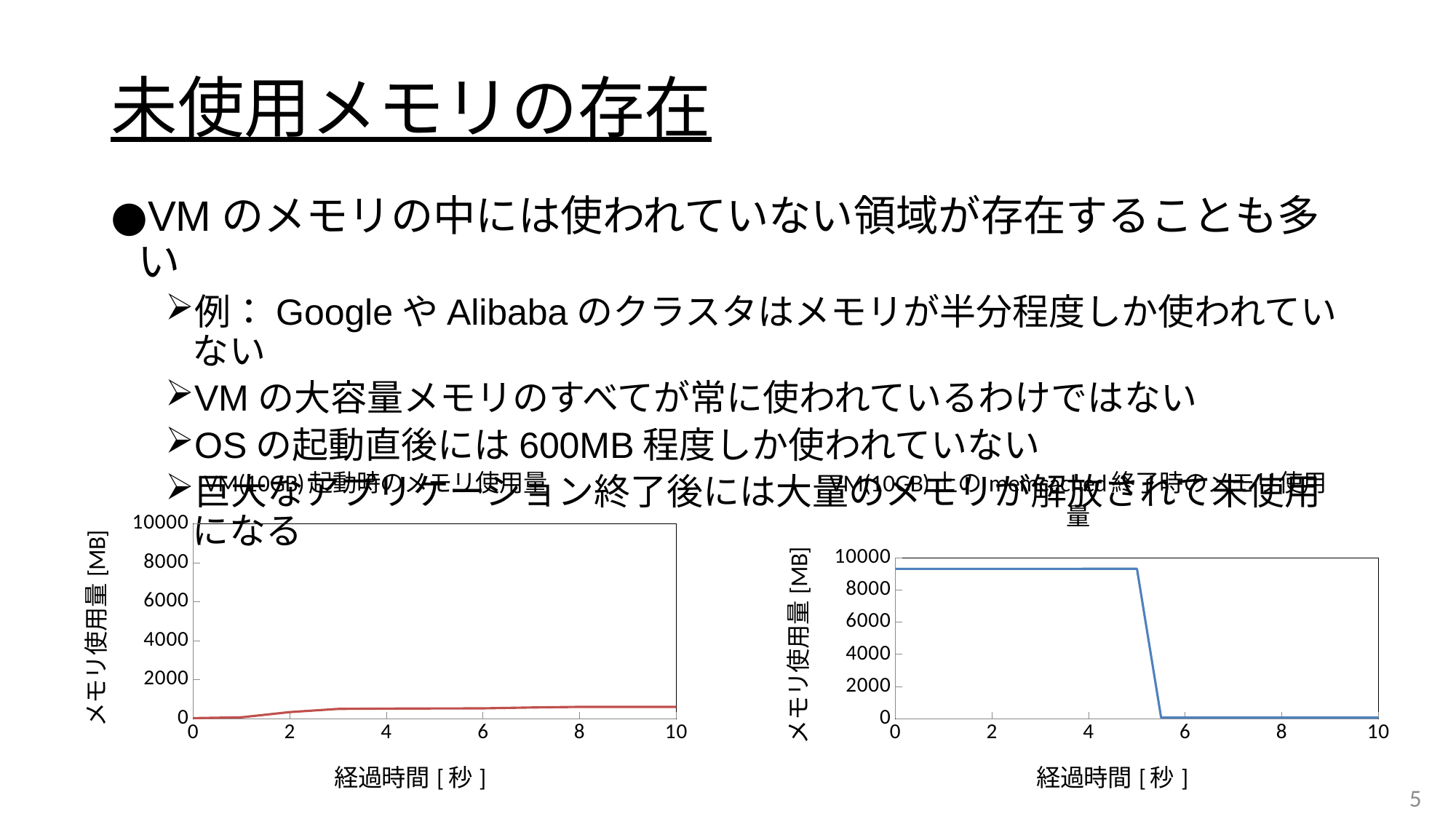
In the right chart, is the memory usage at 4 seconds greater or less than 6000? greater In the right chart, is the memory usage at 2 seconds greater or less than 8000? greater What is the label of the y axis on the left chart? メモリ使用量 [MB] What is the label of the x axis on the right chart? 経過時間 [秒] In the left chart, is the memory usage at 10 seconds greater or less than 2000? less At 2 seconds of elapsed time, which chart shows the larger memory usage, the left chart or the right chart? the right chart In the right chart, do the values rise or fall as elapsed time increases from 0 to 10 seconds? fall In the left chart, do the values rise or fall as elapsed time increases from 0 to 10 seconds? rise What kind of chart is the left chart on the slide? line chart In the right chart, is the memory usage larger at 2 seconds or at 8 seconds? 2 seconds